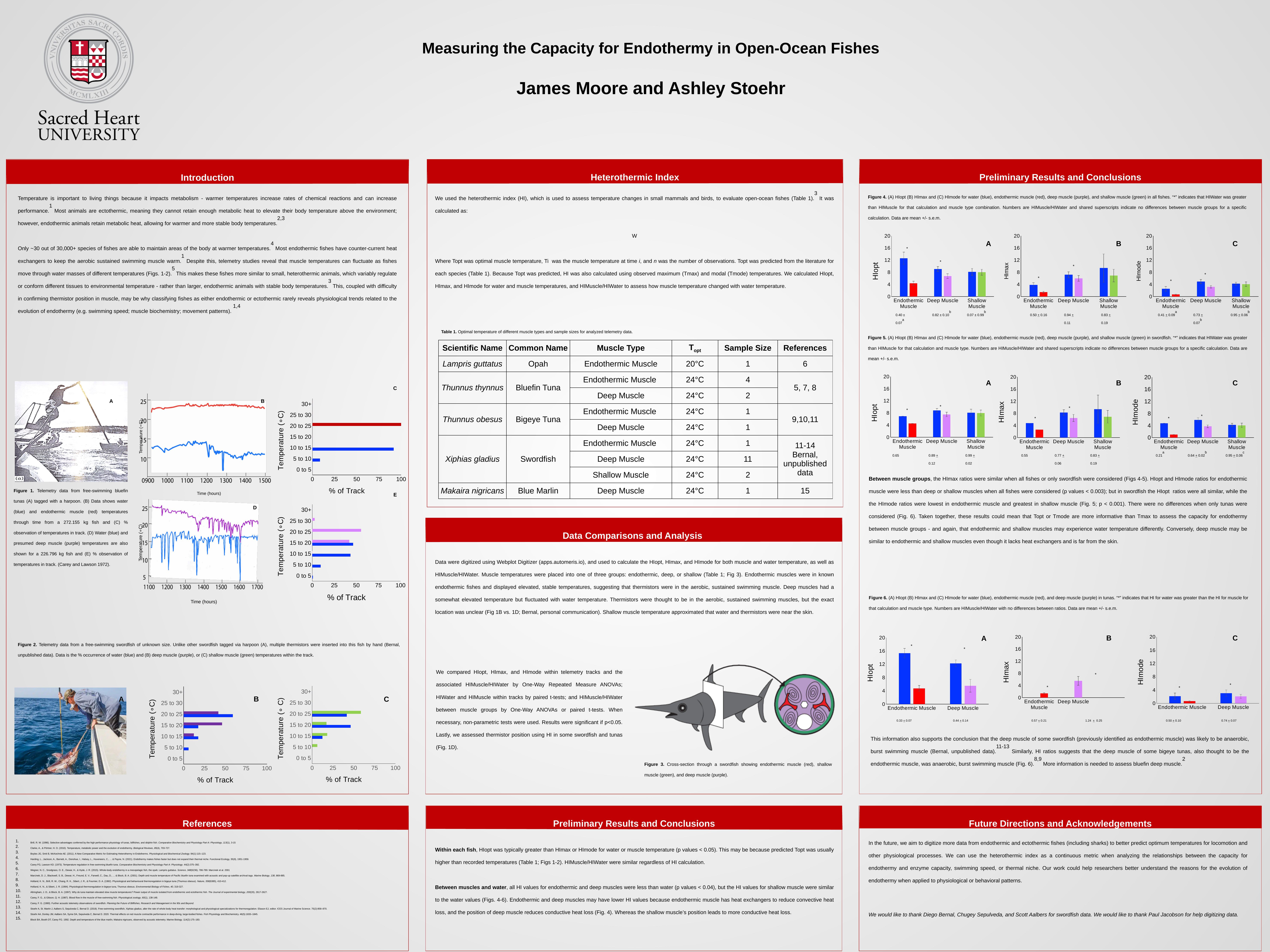
In Figure 4 panel A (HIopt), which muscle category has the lowest muscle (non-blue) bar? Endothermic Muscle In Figure 6 panel A (HIopt), is the blue bar for Endothermic Muscle greater or less than 12? greater In Figure 4 panel A (HIopt), is the red (endothermic muscle) bar for Endothermic Muscle greater or less than 8? less In Figure 6 panel A (HIopt), which category has the taller blue bar, Endothermic Muscle or Deep Muscle? Endothermic Muscle In Figure 1 panel C, is the blue bar for the 10 to 15 temperature bin greater or less than 75% of track? greater In Figure 1 panel C, which temperature bin has the red bar? 20 to 25 In Figure 1 panel B, what kind of chart is shown? line chart In Figure 4 panel A (HIopt), what kind of chart is shown? bar chart In Figure 4 panel A (HIopt), how many muscle categories are shown on the x axis? 3 In Figure 6 panel A (HIopt), how many muscle categories are shown on the x axis? 2